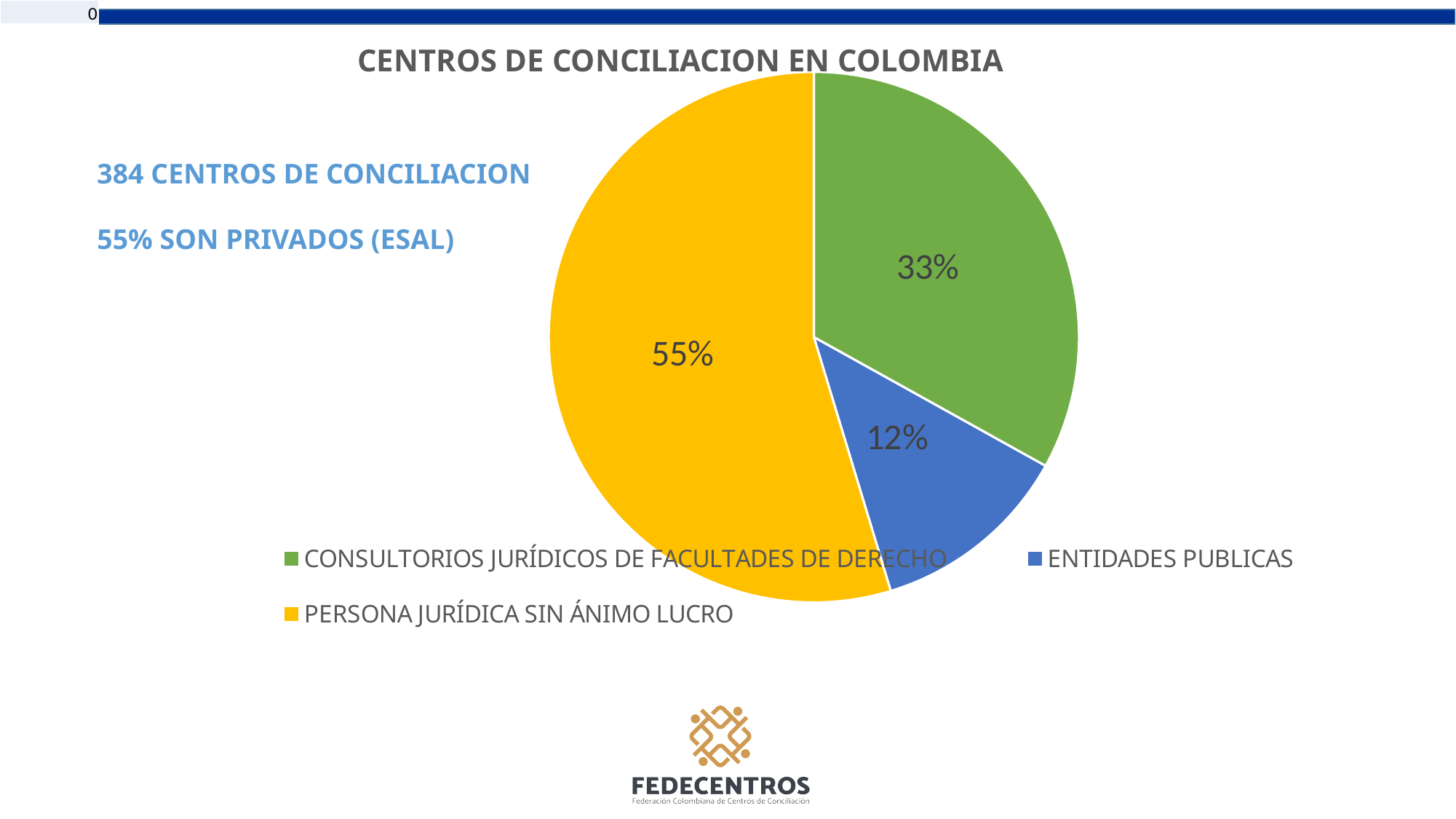
What is the difference in percentage points between PERSONA JURÍDICA SIN ÁNIMO LUCRO and CONSULTORIOS JURÍDICOS DE FACULTADES DE DERECHO? 22% Which category has the largest slice of the pie? PERSONA JURÍDICA SIN ÁNIMO LUCRO What is the title of the chart? CENTROS DE CONCILIACION EN COLOMBIA Which is larger, the slice for CONSULTORIOS JURÍDICOS DE FACULTADES DE DERECHO or the slice for ENTIDADES PUBLICAS? CONSULTORIOS JURÍDICOS DE FACULTADES DE DERECHO What share of the pie does CONSULTORIOS JURÍDICOS DE FACULTADES DE DERECHO represent? 33% What share of the pie does PERSONA JURÍDICA SIN ÁNIMO LUCRO represent? 55% What share of the pie does ENTIDADES PUBLICAS represent? 12% How many categories does the pie chart have? 3 What kind of chart is shown on the slide? pie chart What is the difference in percentage points between CONSULTORIOS JURÍDICOS DE FACULTADES DE DERECHO and ENTIDADES PUBLICAS? 21% Which category has the smallest slice of the pie? ENTIDADES PUBLICAS What colour is the slice for ENTIDADES PUBLICAS? blue